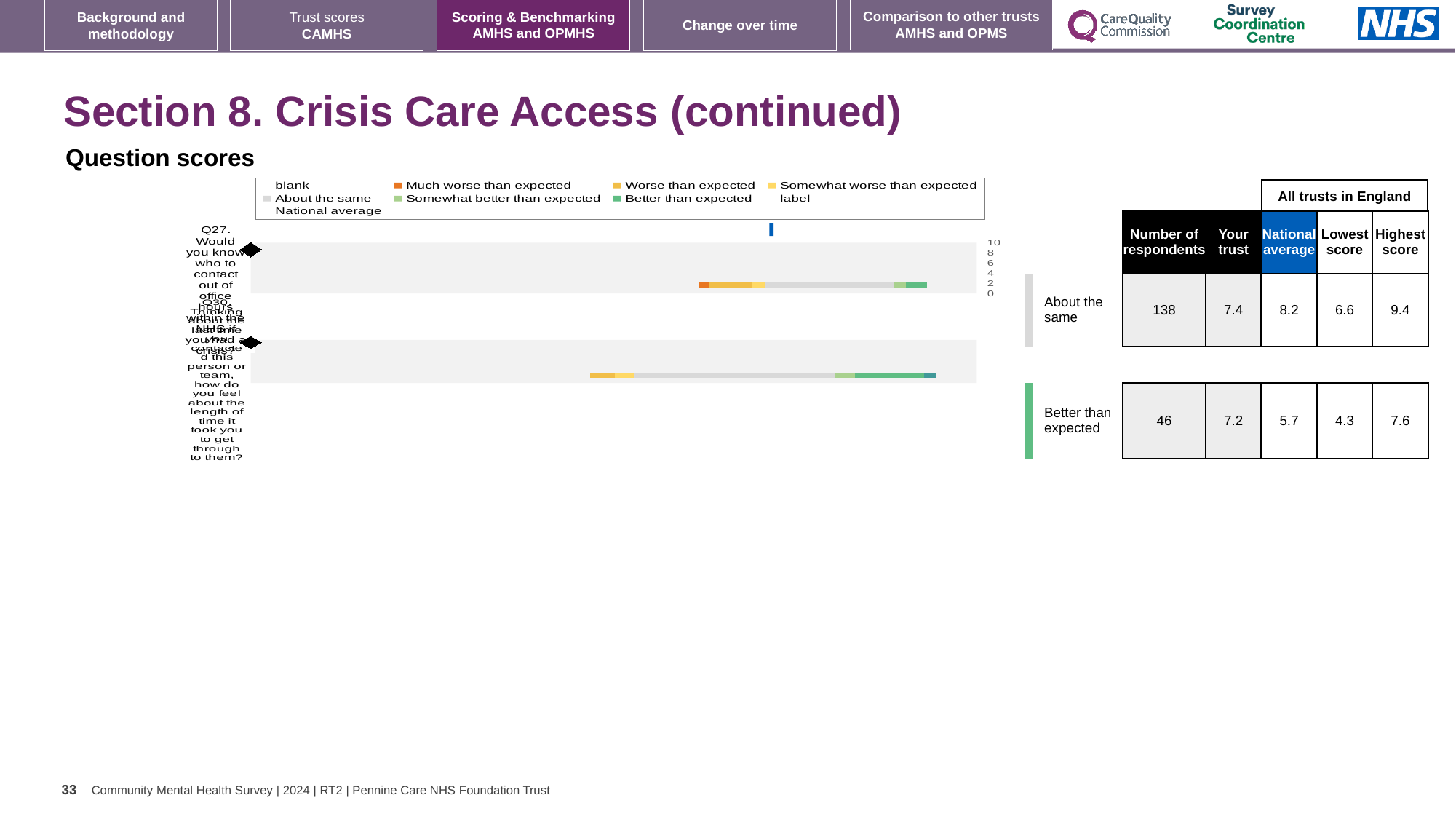
How many entries does the legend of the Question scores chart list? 9 In the table beside the chart, what is the difference in number of respondents between the 'About the same' row and the 'Better than expected' row? 92 How many questions (bars) are plotted in the Question scores chart? 2 In the table beside the chart, what is the 'Your trust' score for the 'Better than expected' row? 7.2 In the table beside the chart, how many respondents are there for the 'About the same' row? 138 What kind of chart is shown under 'Question scores'? bar chart In the table beside the chart, what is the National average for the 'About the same' row? 8.2 In the table beside the chart, what is the difference between the Highest score and Lowest score for the 'About the same' row? 2.8 In the table beside the chart, which is larger for the 'Better than expected' row: Your trust or National average? Your trust What is the highest tick value shown on the axis of the Question scores chart? 10 In the table beside the chart, which is larger for the 'About the same' row: Your trust or National average? National average